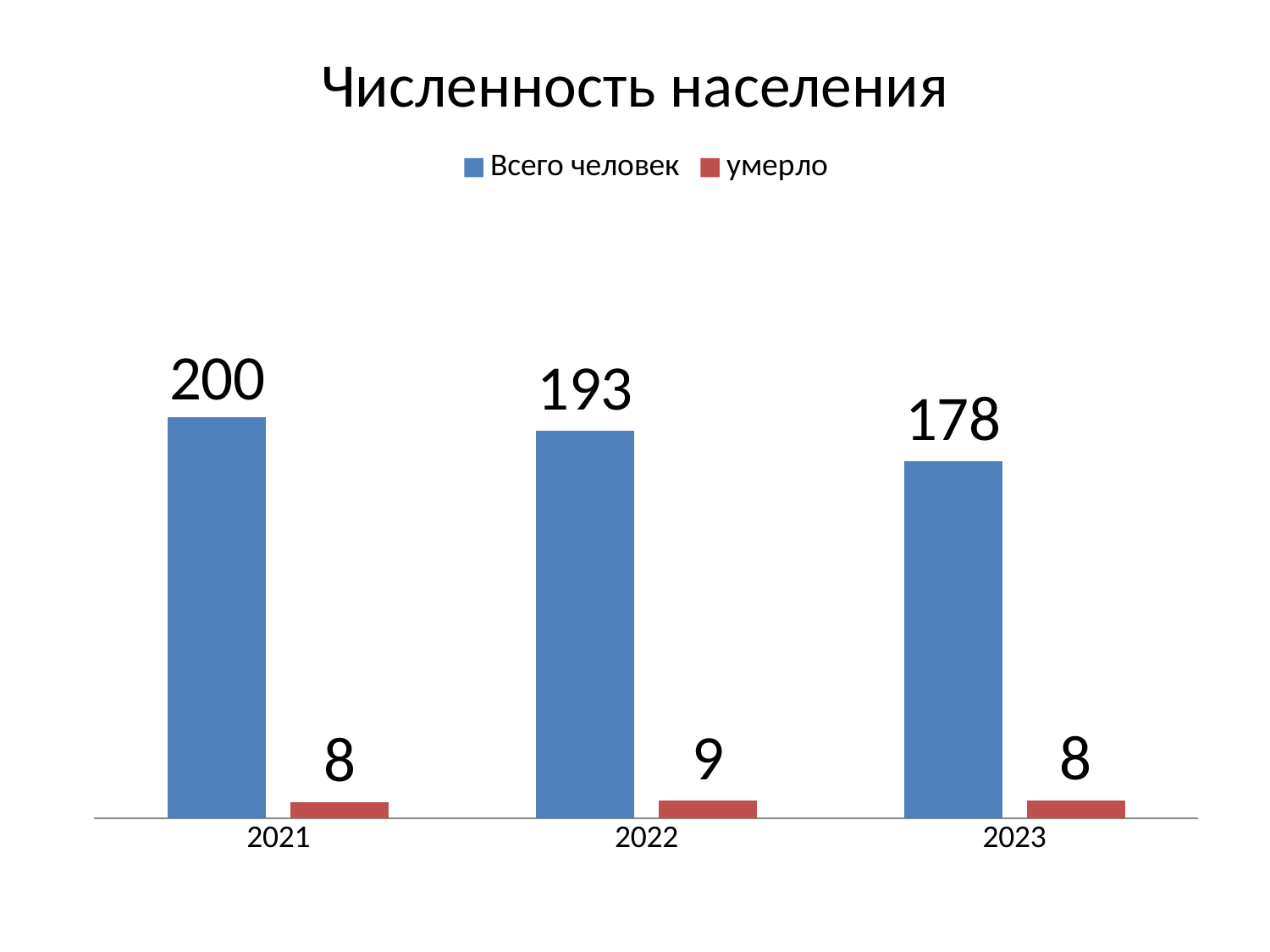
How many years are shown on the x axis? 3 What is the value of "Всего человек" for 2023? 178 What kind of chart is shown on the slide? Bar chart Which is larger: "Всего человек" for 2022 or for 2023? 2022 What is the difference between the "Всего человек" values for 2021 and 2023? 22 Which year has the highest value for "Всего человек"? 2021 Does the "Всего человек" series rise or fall from 2021 to 2023? Fall Which year has the lowest value for "Всего человек"? 2023 What is the value of "умерло" for 2022? 9 What is the value of "Всего человек" for 2021? 200 What is the difference between the "Всего человек" values for 2022 and 2023? 15 How many series does the legend list? 2